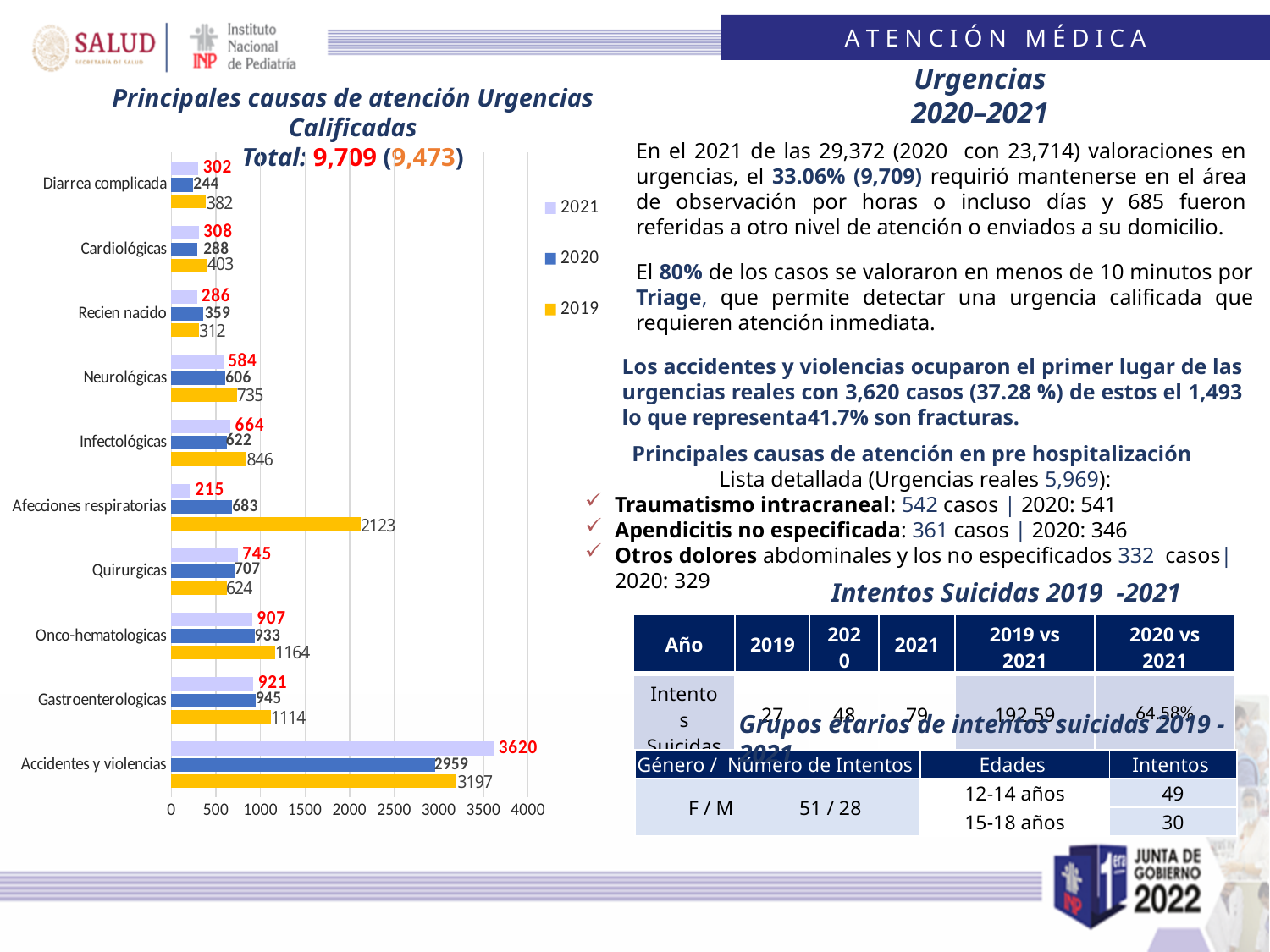
What is the difference between the 2021 and 2020 values for Accidentes y violencias in the Urgencias Calificadas chart? 661 What is the 2019 value for Afecciones respiratorias in the Urgencias Calificadas chart? 2123 Which category has the lowest 2021 value in the Urgencias Calificadas chart? Afecciones respiratorias Which colour represents the 2019 series in the Urgencias Calificadas chart? Yellow Which category has the highest 2021 value in the Urgencias Calificadas chart? Accidentes y violencias What is the 2020 value for Gastroenterologicas in the Urgencias Calificadas chart? 945 What type of chart is used to show the main causes of attention in Urgencias Calificadas? Bar chart In the Urgencias Calificadas chart, which is larger for Quirurgicas: the 2021 value or the 2019 value? 2021 In the Urgencias Calificadas chart, is the 2019 value for Afecciones respiratorias greater or less than 2000? greater What is the 2021 value for Accidentes y violencias in the Urgencias Calificadas chart? 3620 How many series does the legend of the Urgencias Calificadas chart list? 3 How many categories (causes) are shown in the Urgencias Calificadas chart? 10